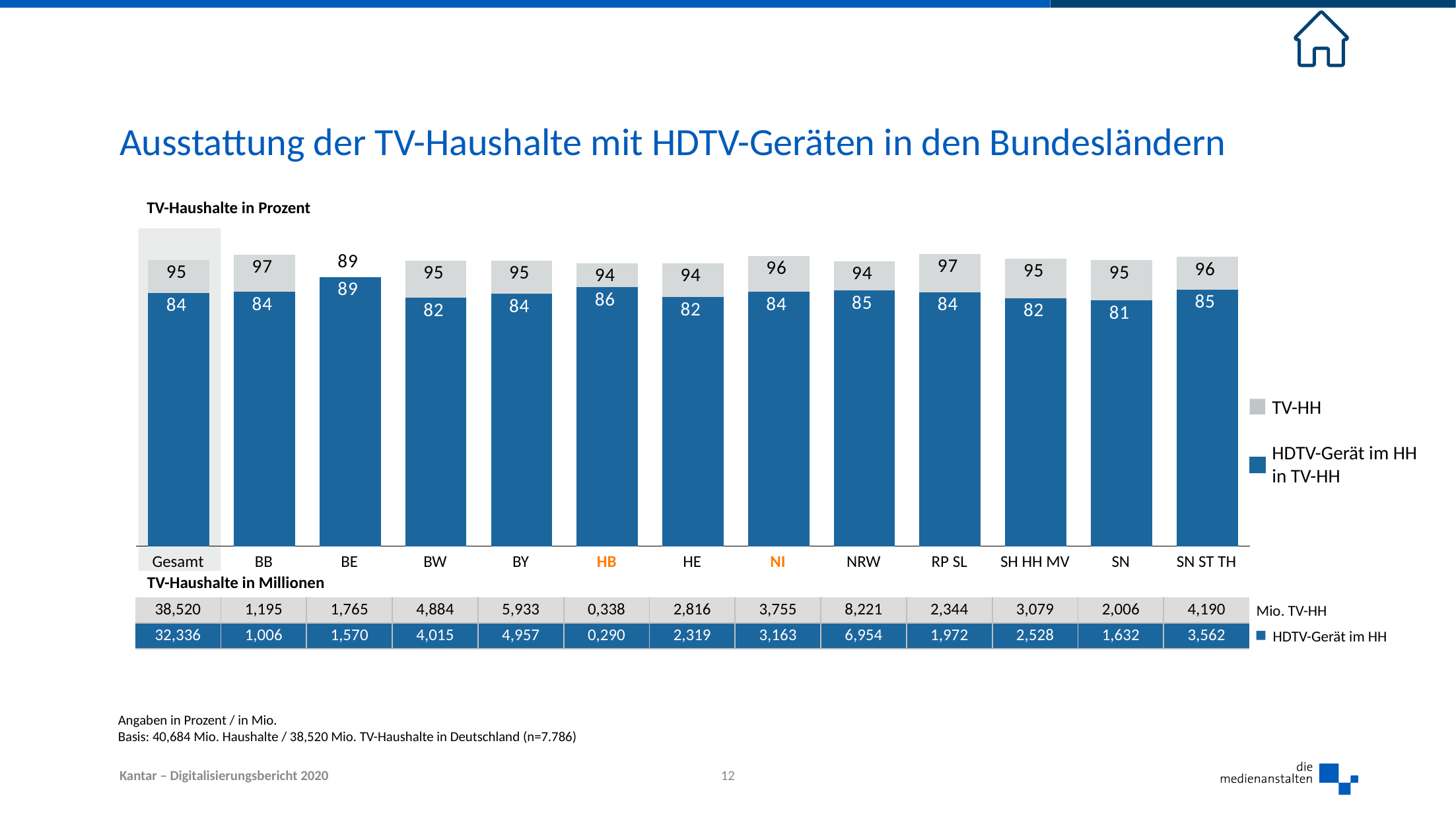
What is the HDTV-Gerät im HH in TV-HH value for BE in the percent chart? 89 Which category has the lowest HDTV-Gerät im HH in TV-HH value in the percent chart? SN What is the difference between the TV-HH value and the HDTV-Gerät im HH in TV-HH value for BW in the percent chart? 13 How many categories are shown on the x axis of the chart? 13 Which is larger in the percent chart: the HDTV-Gerät im HH in TV-HH value for HB or for HE? HB Which category has the highest HDTV-Gerät im HH in TV-HH value in the percent chart? BE How many series does the legend of the percent chart list? 2 What kind of chart is shown on the slide? bar chart What is the TV-HH value for NRW in the percent chart? 94 What is the title of the slide? Ausstattung der TV-Haushalte mit HDTV-Geräten in den Bundesländern What is the Mio. TV-HH value for NRW in the table below the chart? 8,221 What is the HDTV-Gerät im HH in TV-HH value for SN in the percent chart? 81